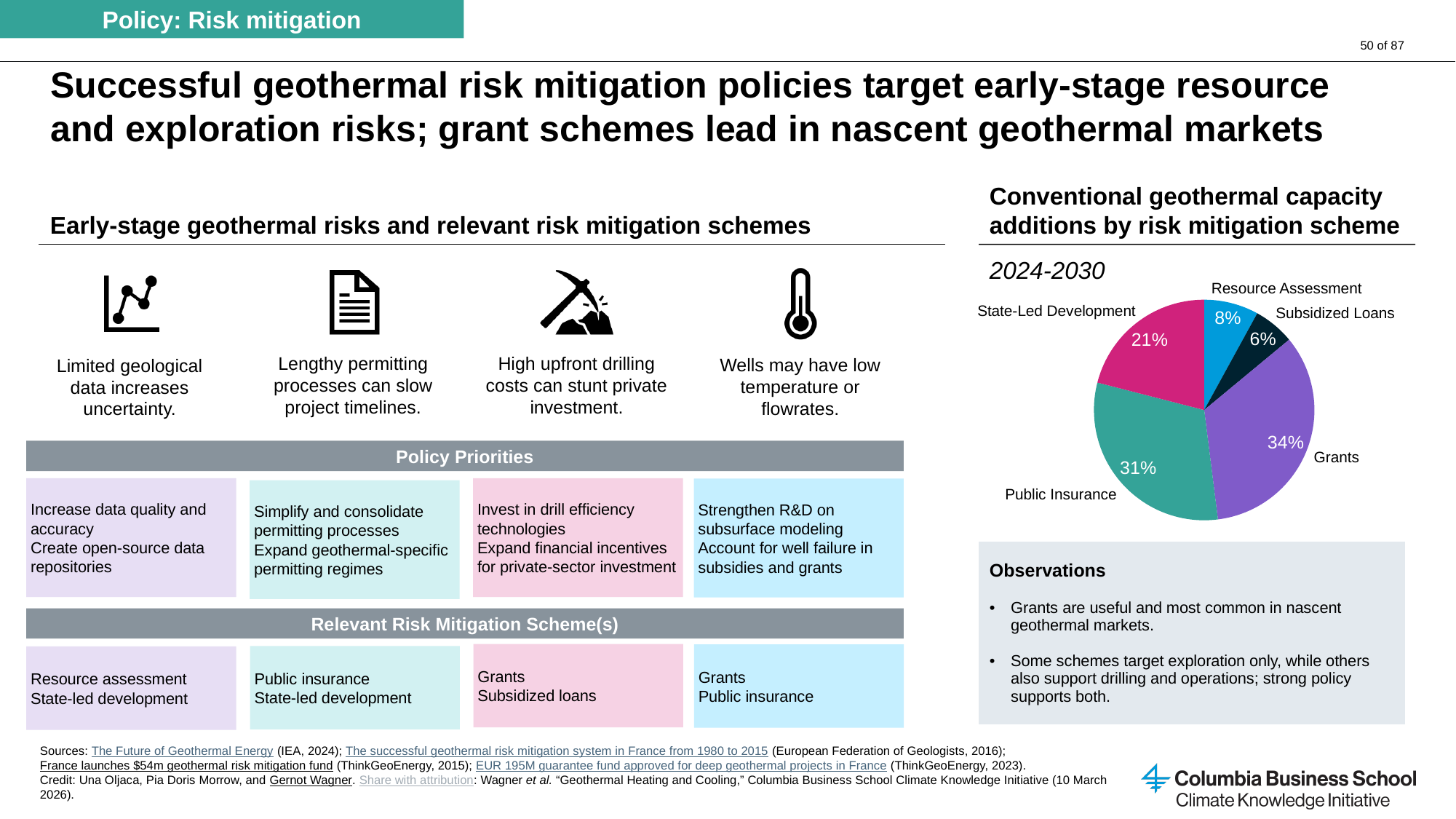
In the pie chart, how many percentage points larger is the Grants share than the State-Led Development share? 13 Which risk mitigation scheme accounts for the largest share of conventional geothermal capacity additions in the pie chart? Grants What type of chart is used to show conventional geothermal capacity additions by risk mitigation scheme? Pie chart What share of conventional geothermal capacity additions (2024-2030) is attributed to Subsidized Loans? 6% Which risk mitigation scheme accounts for the smallest share of conventional geothermal capacity additions in the pie chart? Subsidized Loans What share of conventional geothermal capacity additions (2024-2030) is attributed to State-Led Development? 21% How many risk mitigation schemes are shown as slices in the pie chart? 5 What share of conventional geothermal capacity additions (2024-2030) is attributed to Grants? 34% What time period does the pie chart of conventional geothermal capacity additions cover? 2024-2030 What share of conventional geothermal capacity additions (2024-2030) is attributed to Resource Assessment? 8% In the pie chart, which has a larger share: Public Insurance or State-Led Development? Public Insurance What share of conventional geothermal capacity additions (2024-2030) is attributed to Public Insurance? 31%